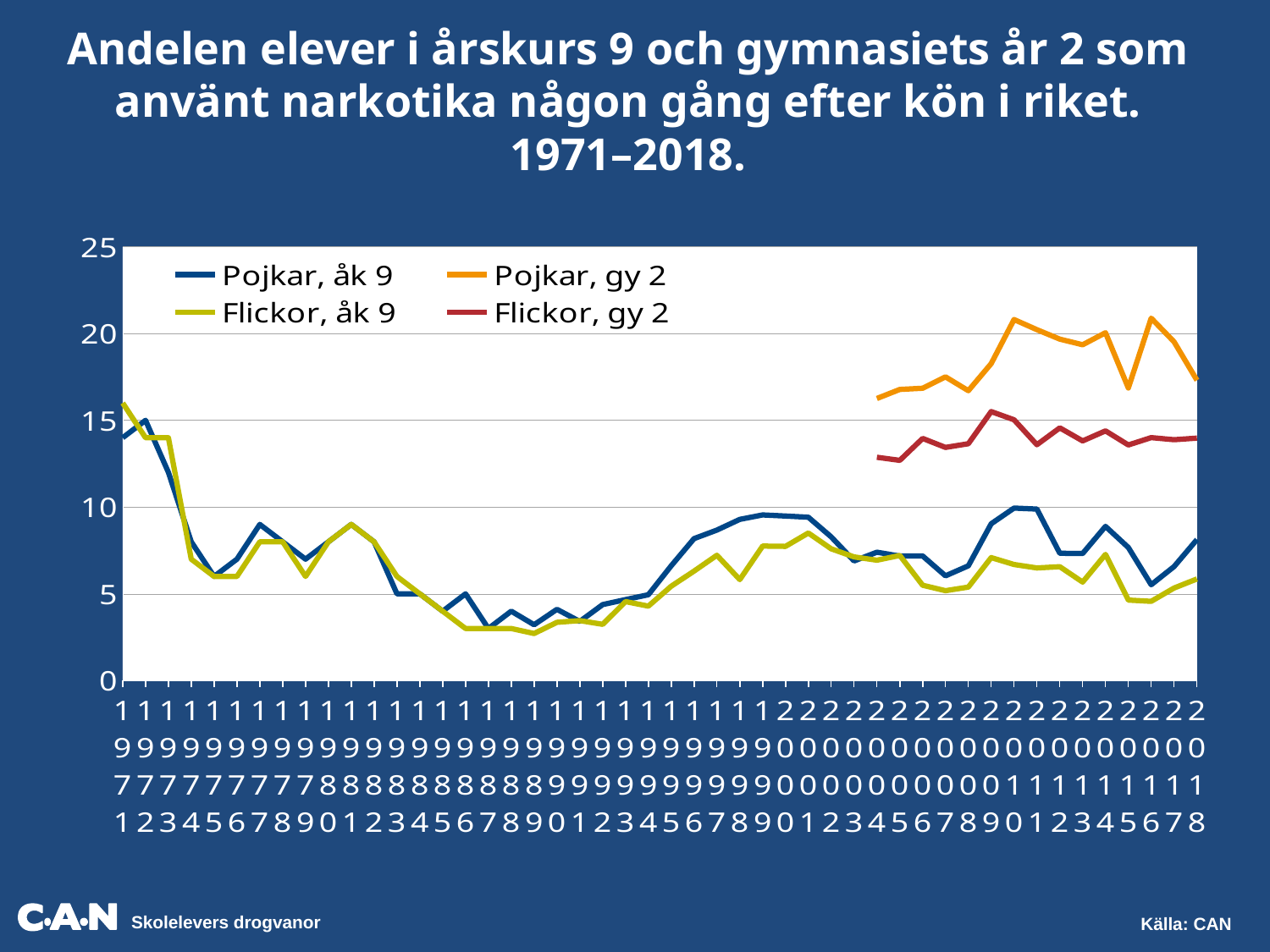
Which series has the lowest value in 2018? Flickor, åk 9 Which series is drawn in orange? Pojkar, gy 2 Which series has the highest value in 2018? Pojkar, gy 2 What is the highest value shown on the y axis? 25 Does the value for Pojkar, åk 9 rise or fall from 1971 to 1975? fall How many series does the legend list? 4 Is the value for Pojkar, gy 2 in 2018 greater or less than 15? greater Is the value for Flickor, gy 2 in 2018 greater or less than 10? greater What kind of chart is shown on the slide? line chart Is the value for Flickor, åk 9 in 1990 greater or less than 5? less